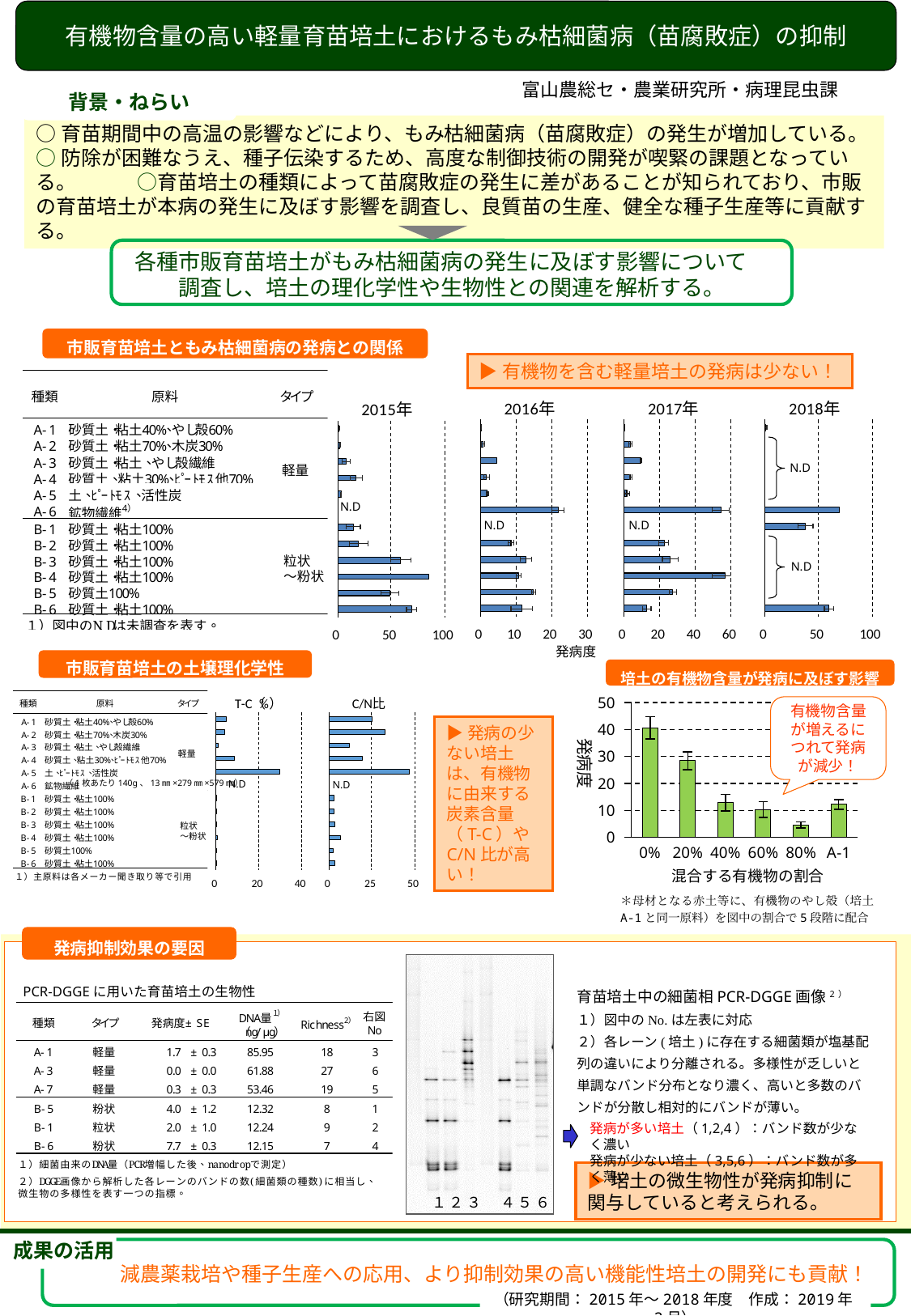
In the chart titled 培土の有機物含量が発病に及ぼす影響, which category has the highest 発病度? 0% In the chart titled 培土の有機物含量が発病に及ぼす影響, do the values rise or fall as the organic matter share goes from 0% to 80%? fall In the chart titled 培土の有機物含量が発病に及ぼす影響, is the value for 0% greater or less than 30? greater In the C/N比 chart, is the value for A-5 greater or less than 25? greater In the 2015年 発病度 chart, which soil type has the highest value? B-4 In the chart titled 培土の有機物含量が発病に及ぼす影響, is the value for 80% greater or less than 10? less In the chart titled 培土の有機物含量が発病に及ぼす影響, which category has the lowest 発病度? 80% How many yearly 発病度 bar charts are shown under the heading 市販育苗培土ともみ枯細菌病の発病との関係? 4 In the chart titled 培土の有機物含量が発病に及ぼす影響, what is the x-axis title? 混合する有機物の割合 What kind of chart is the chart titled 培土の有機物含量が発病に及ぼす影響? bar chart In the chart titled 培土の有機物含量が発病に及ぼす影響, how many categories are shown on the x axis? 6